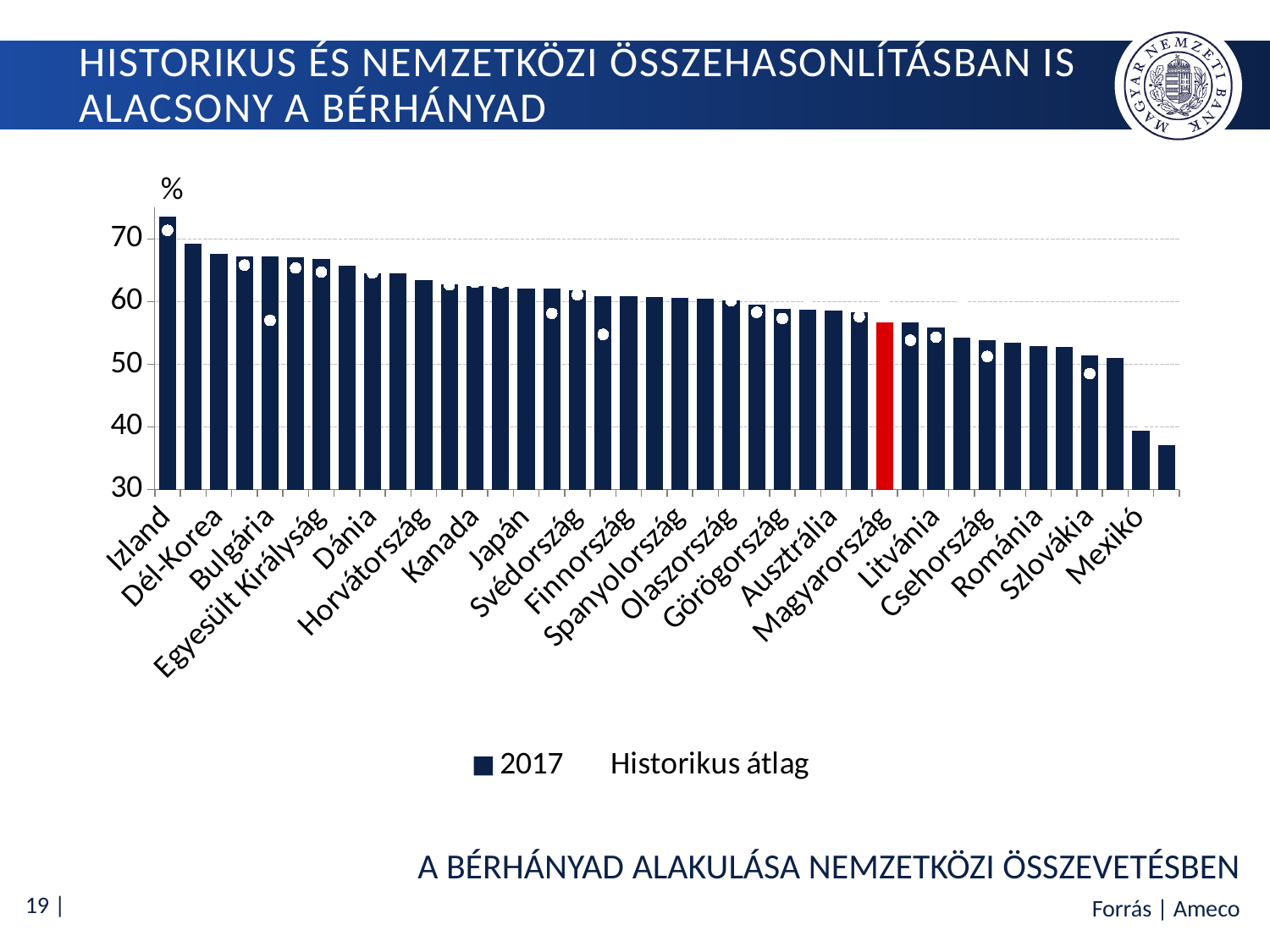
Is the 2017 value for Dél-Korea greater or less than 70? less Is the 2017 value for Magyarország greater or less than 50? greater How many series does the legend list? 2 Which has the larger 2017 bar, Izland or Magyarország? Izland Do the 2017 bar values rise or fall from left to right along the x axis? fall What kind of chart is shown on the slide? combination bar and line chart (bars with dot markers) Which country's bar is highlighted in red? Magyarország Is the 2017 value for Izland greater or less than 70? greater Which country has the highest 2017 bar? Izland Which has the larger 2017 bar, Magyarország or Mexikó? Magyarország